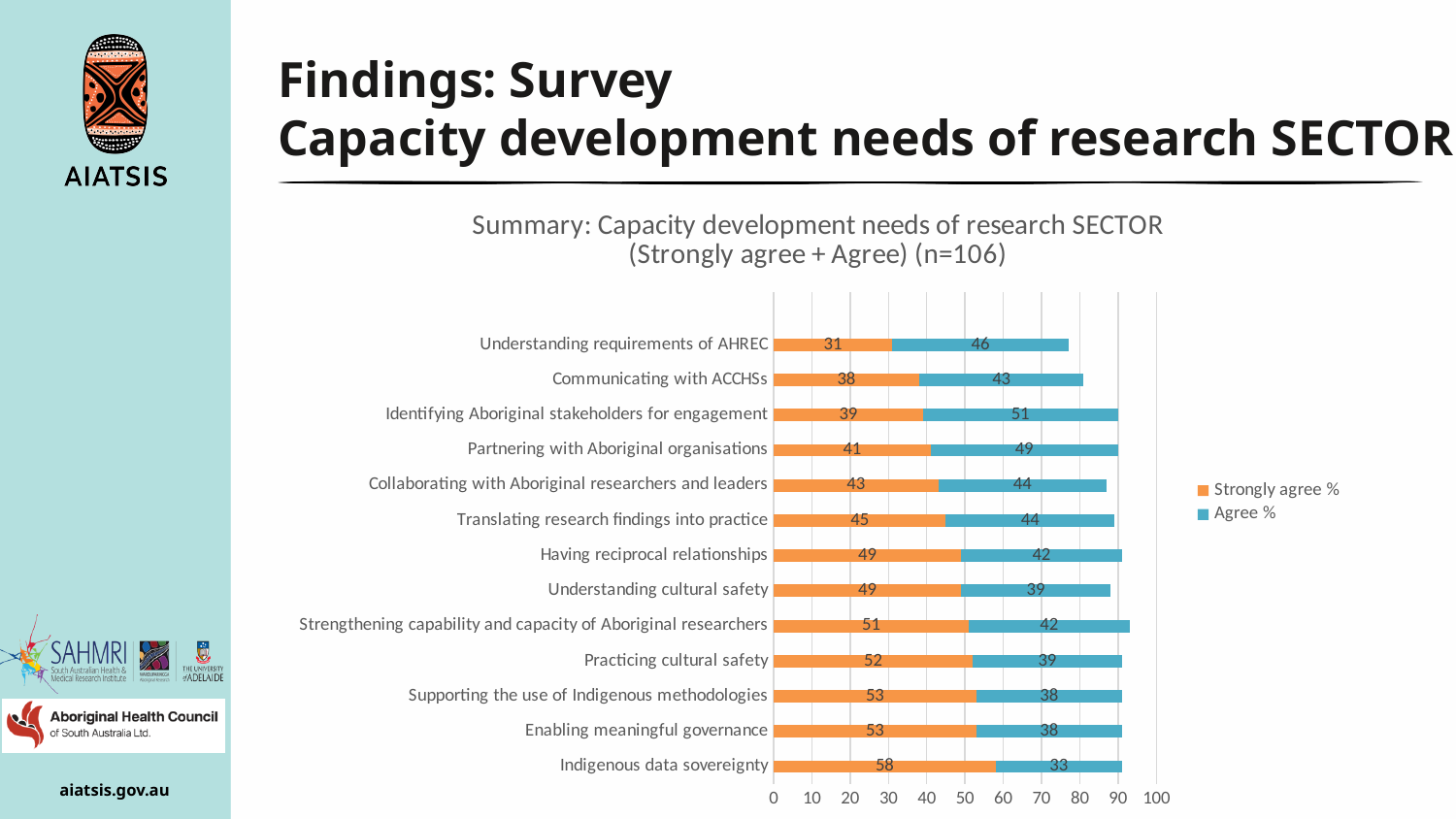
How many categories are plotted in the chart? 13 What is the difference between the Strongly agree % values for Indigenous data sovereignty and Understanding requirements of AHREC? 27 What is the Agree % value for Communicating with ACCHSs? 43 What is the sample size (n) stated in the chart title? n=106 How many series does the legend list? 2 What is the Strongly agree % value for Indigenous data sovereignty? 58 Which category has the highest Agree % value? Identifying Aboriginal stakeholders for engagement What type of chart is shown on the slide? Stacked bar chart What is the combined total (Strongly agree % plus Agree %) for Strengthening capability and capacity of Aboriginal researchers? 93 Which category has the lowest Strongly agree % value? Understanding requirements of AHREC Which is larger: the Strongly agree % for Practicing cultural safety or the Strongly agree % for Understanding cultural safety? Practicing cultural safety Which category has the highest Strongly agree % value? Indigenous data sovereignty